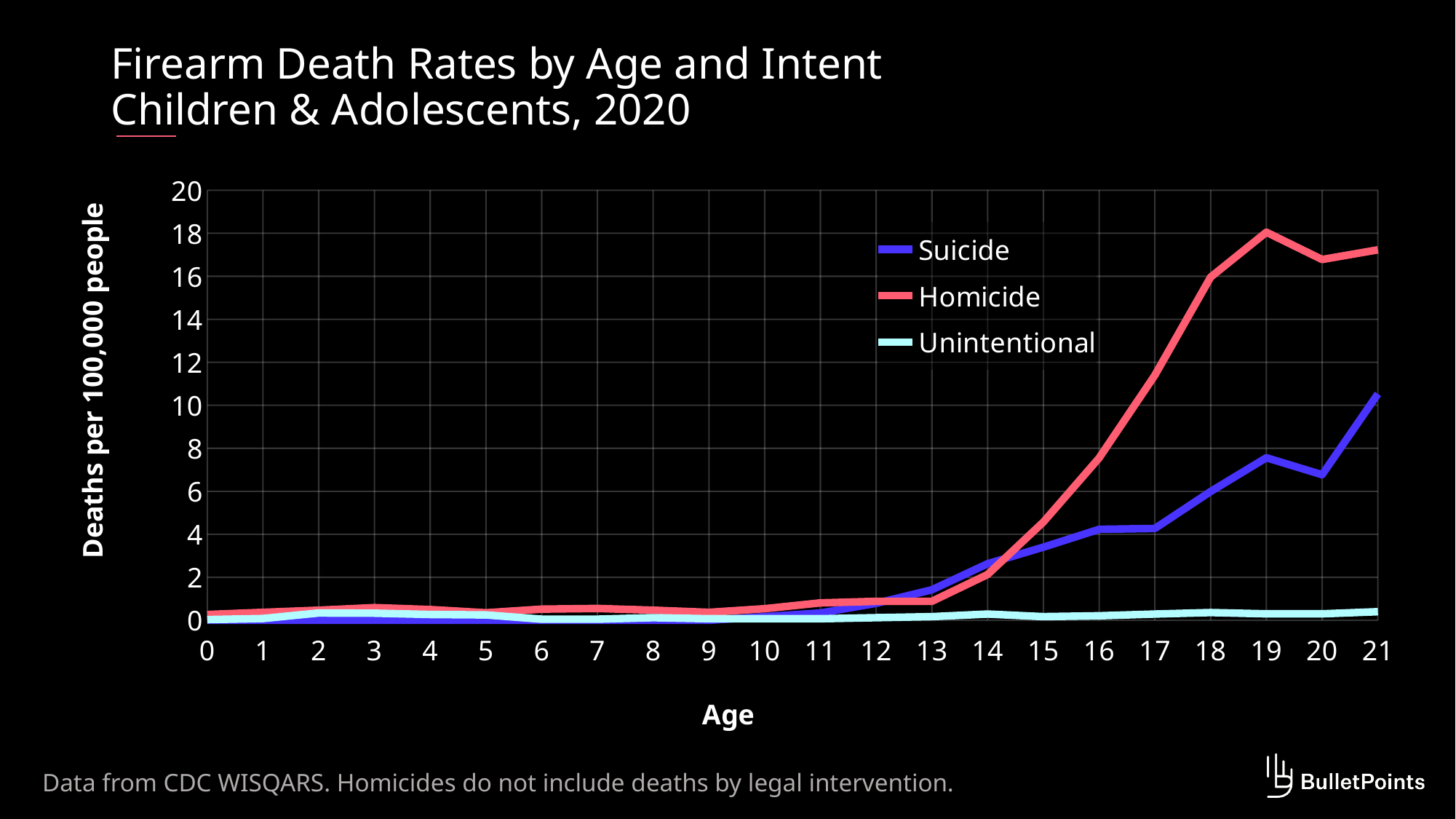
Is the Suicide value at age 21 greater or less than 10? greater What is the label of the y axis? Deaths per 100,000 people At which age does the Homicide line reach its highest value? 19 Does the Homicide line generally rise or fall between age 13 and age 19? rise What kind of chart is shown on the slide? line chart Is the Suicide value at age 16 greater or less than 6? less How many age points are plotted along the x axis? 22 How many series does the legend list? 3 Which is larger at age 20, the Homicide value or the Suicide value? Homicide Is the Homicide value at age 18 greater or less than 14? greater Which series has the highest value at age 19? Homicide Which series has the lowest value at age 21? Unintentional